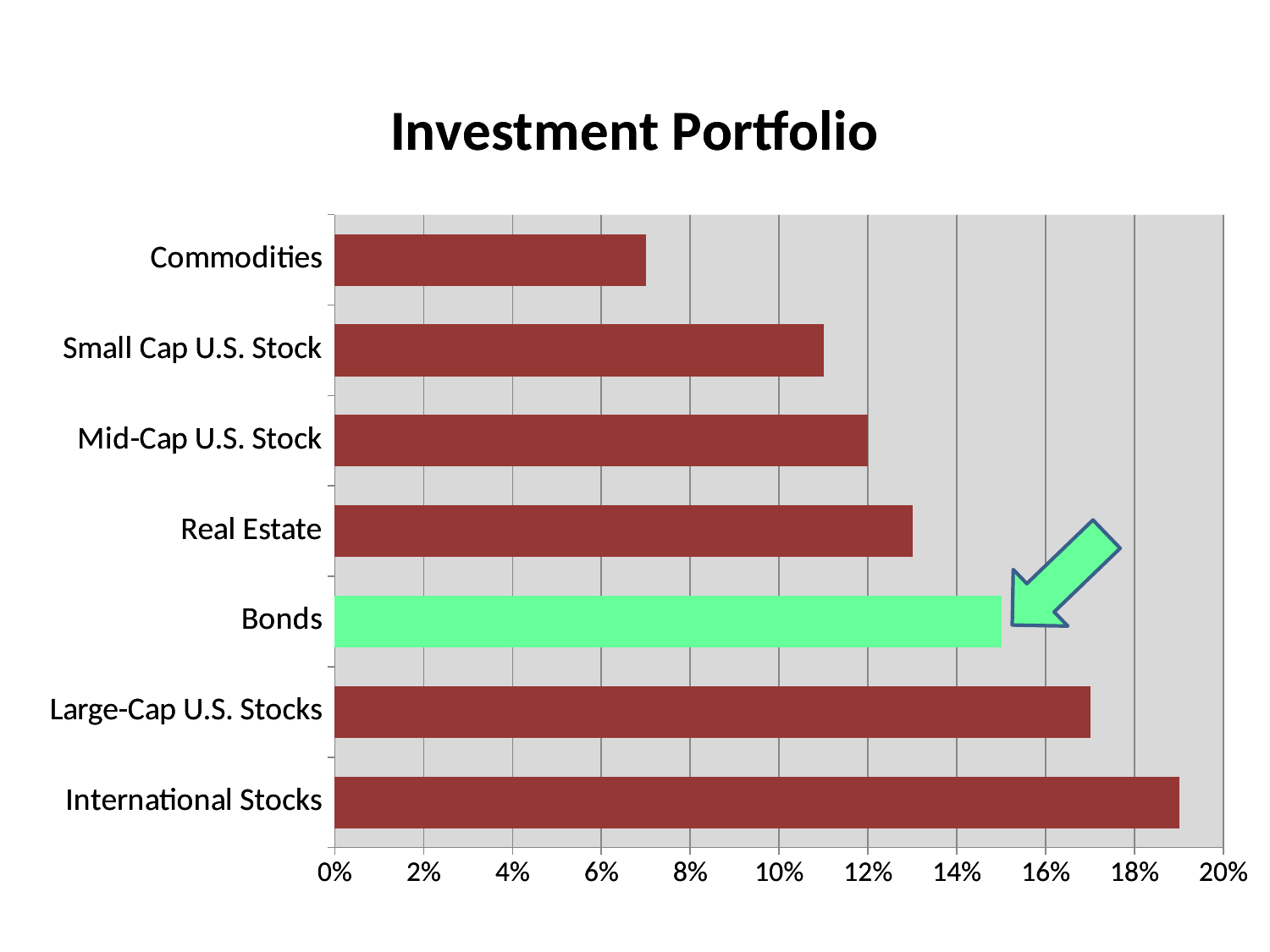
Which is larger, the value for Real Estate or the value for Large-Cap U.S. Stocks? Large-Cap U.S. Stocks Which bar is highlighted in a different colour and pointed to by an arrow? Bonds Is the value for International Stocks greater or less than 18%? greater Which category has the lowest value? Commodities What is the title of the chart? Investment Portfolio Is the value for Small Cap U.S. Stock greater or less than 10%? greater How many categories are shown in the chart? 7 Which category has the highest value? International Stocks Is the value for Bonds greater or less than 14%? greater What type of chart is shown on the slide? bar chart What is the value for Mid-Cap U.S. Stock? 12%